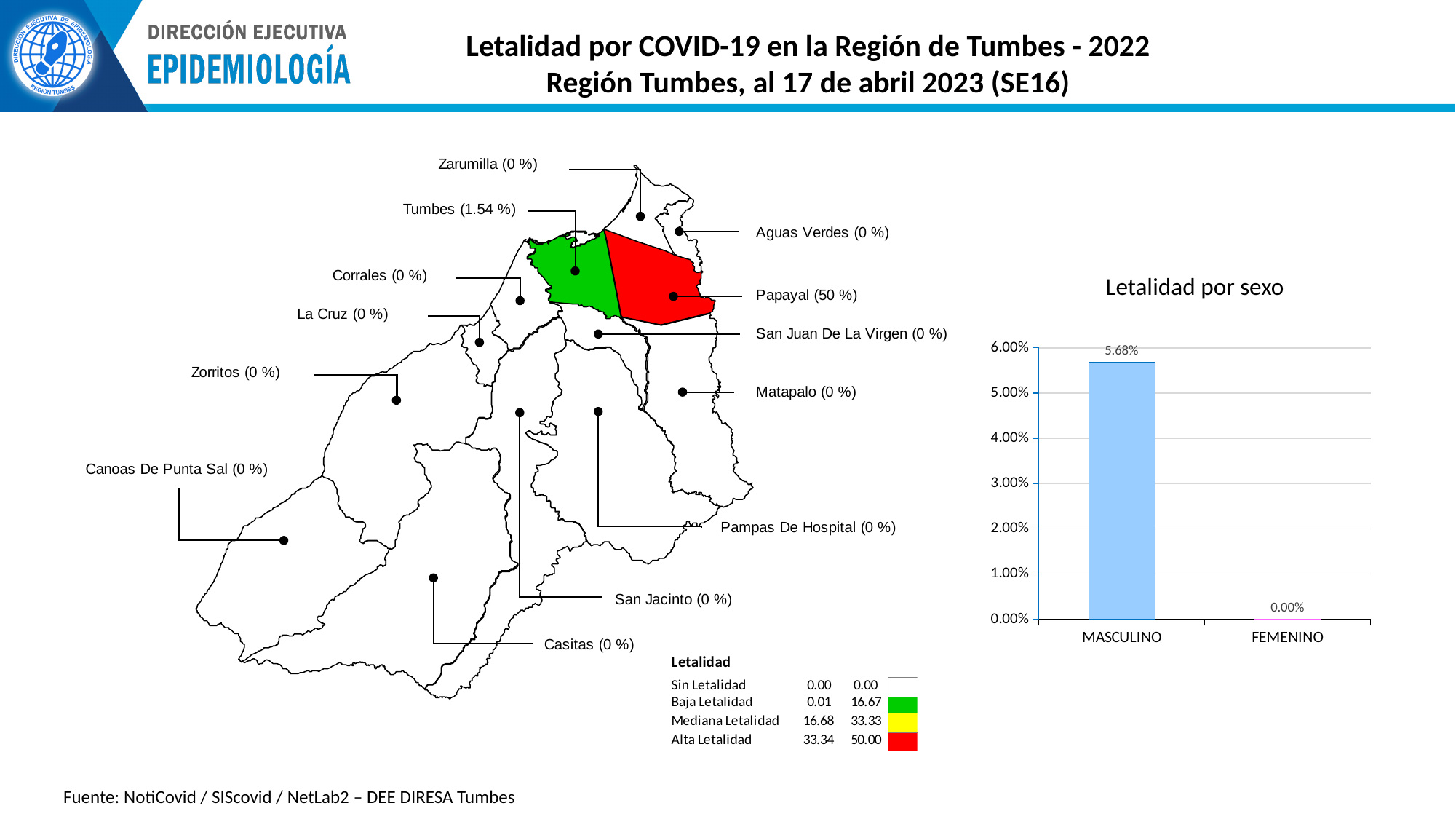
What kind of chart is 'Letalidad por sexo'? bar chart In the 'Letalidad por sexo' chart, what is the difference between the MASCULINO and FEMENINO values? 5.68% What is the highest tick value shown on the y axis of the 'Letalidad por sexo' chart? 6.00% In the 'Letalidad por sexo' chart, which category has the highest value? MASCULINO On the map, what is the lethality value shown for Papayal? 50 % In the 'Letalidad por sexo' chart, what is the value for FEMENINO? 0.00% In the 'Letalidad por sexo' chart, what is the value for MASCULINO? 5.68% In the 'Letalidad por sexo' chart, is the value for MASCULINO greater or less than 5.00%? greater In the 'Letalidad por sexo' chart, which is larger, the value for MASCULINO or for FEMENINO? MASCULINO On the map, what is the lethality value shown for Tumbes? 1.54 % In the 'Letalidad por sexo' chart, which category has the lowest value? FEMENINO How many categories are shown on the x axis of the 'Letalidad por sexo' chart? 2